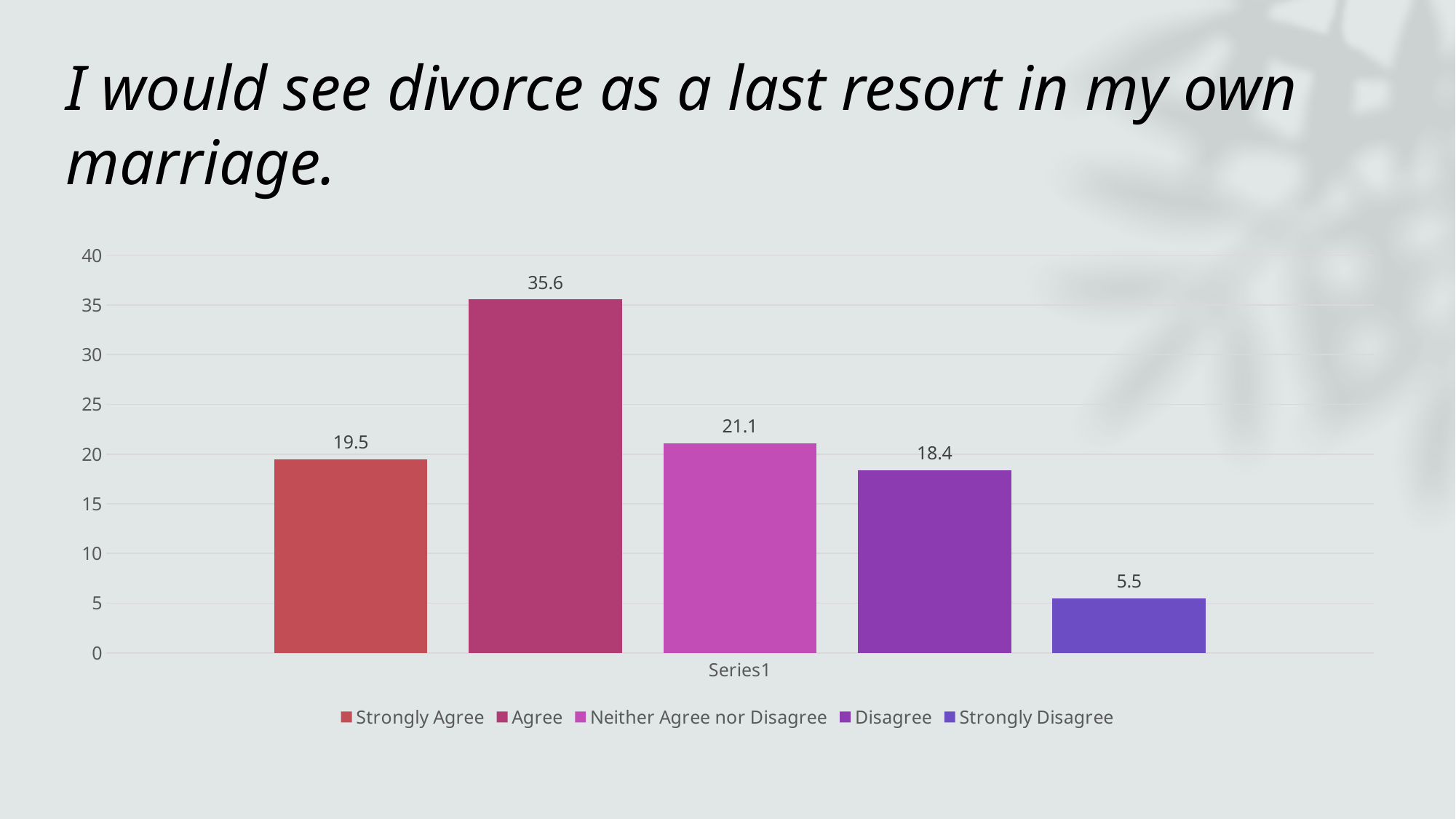
Which response category has the lowest value? Strongly Disagree How many entries does the legend list? 5 Which is larger, the value for Strongly Agree or the value for Disagree? Strongly Agree Is the value for Disagree greater or less than 20? less What is the value for Agree? 35.6 How many bars are shown in the chart? 5 What is the value for Strongly Disagree? 5.5 What kind of chart is shown on the slide? bar chart What is the difference between the values for Agree and Strongly Agree? 16.1 What is the value for Neither Agree nor Disagree? 21.1 What is the title of the slide above the chart? I would see divorce as a last resort in my own marriage. Which response category has the highest value? Agree